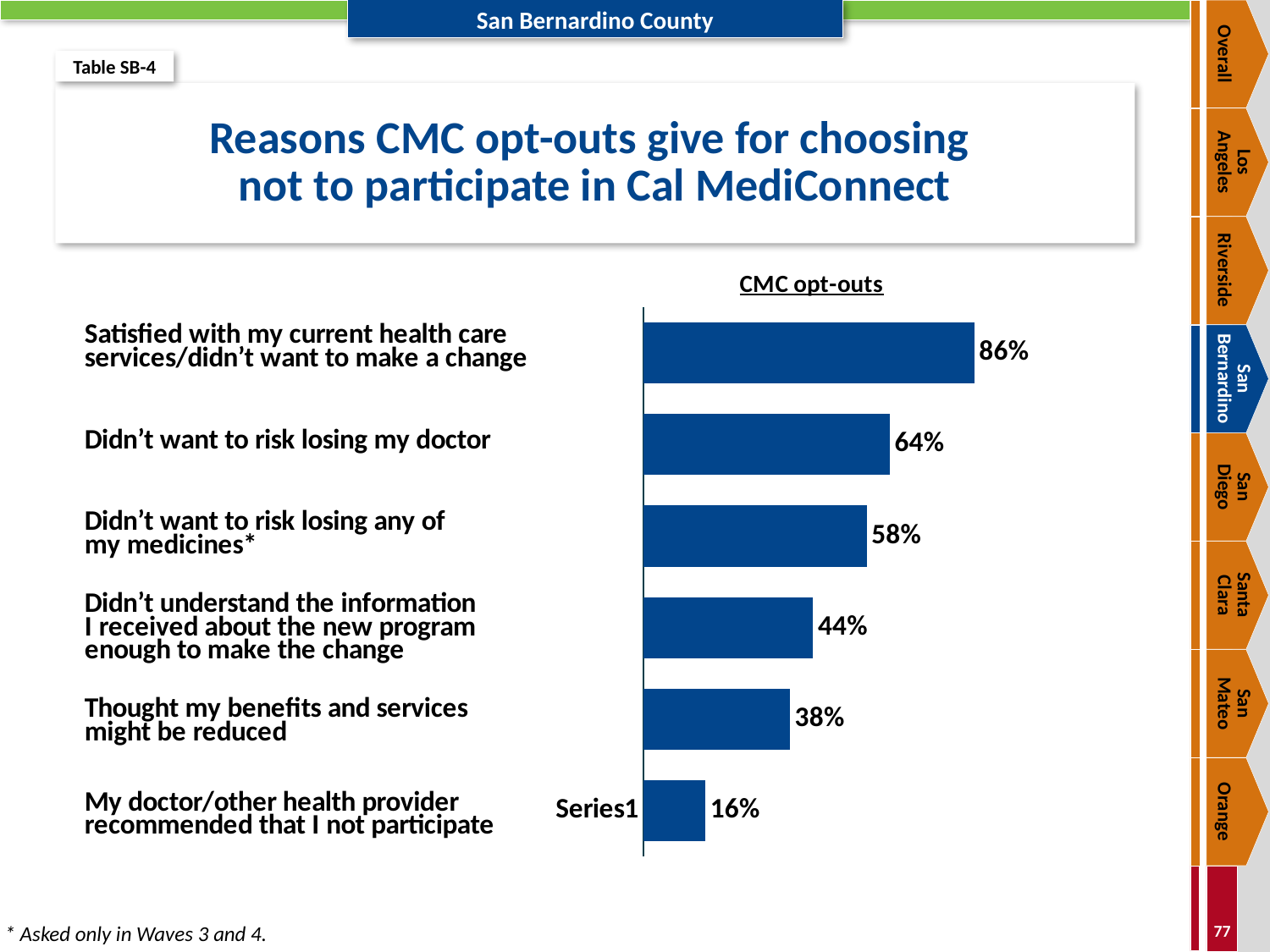
Which reason has the highest percentage on the chart? Satisfied with my current health care services/didn't want to make a change What value is shown for 'Didn't want to risk losing any of my medicines'? 58% How many reasons are plotted on the chart? 6 Which is larger: the percentage for 'Didn't understand the information I received about the new program enough to make the change' or for 'Thought my benefits and services might be reduced'? Didn't understand the information I received about the new program enough to make the change What percentage of CMC opt-outs said their doctor/other health provider recommended that they not participate? 16% What percentage of CMC opt-outs said they didn't want to risk losing their doctor? 64% What kind of chart is shown on the slide? Bar chart What percentage of CMC opt-outs said they were satisfied with their current health care services/didn't want to make a change? 86% Which reason has the lowest percentage on the chart? My doctor/other health provider recommended that I not participate What label appears above the bars on the chart? CMC opt-outs What is the title of the chart? Reasons CMC opt-outs give for choosing not to participate in Cal MediConnect What is the difference between the percentage for 'Didn't want to risk losing my doctor' and 'Thought my benefits and services might be reduced'? 26%